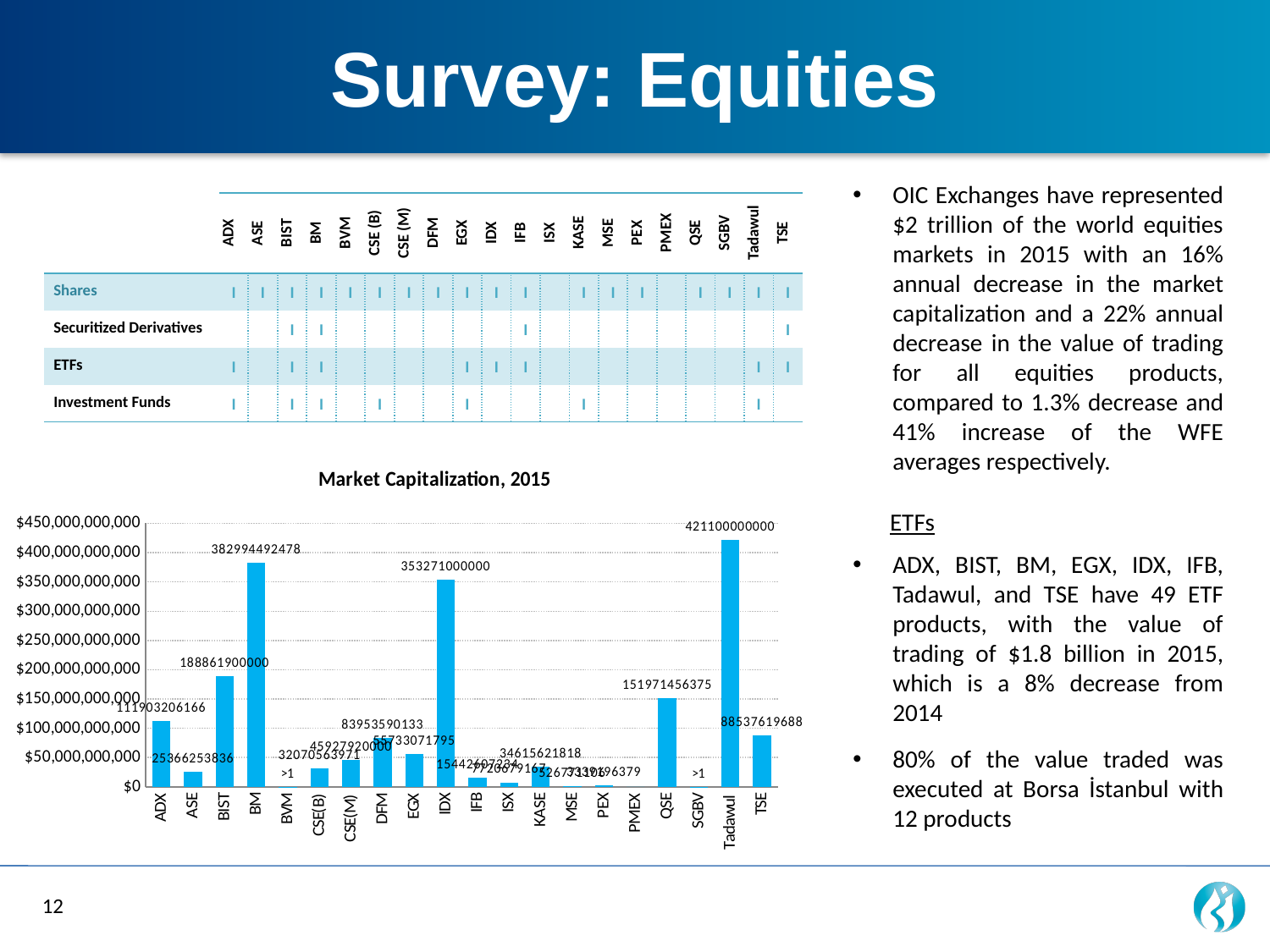
In the Market Capitalization, 2015 chart, what is the value for QSE? 151971456375 In the Market Capitalization, 2015 chart, is the value for EGX greater or less than $100,000,000,000? less In the Market Capitalization, 2015 chart, which exchange has the highest market capitalization? Tadawul In the Market Capitalization, 2015 chart, what is the difference between the values for Tadawul and BM? 38105507522 What kind of chart is the Market Capitalization, 2015 chart? bar chart How many exchanges are shown on the x axis of the Market Capitalization, 2015 chart? 20 In the Market Capitalization, 2015 chart, what is the value for Tadawul? 421100000000 What is the title of the chart at the bottom left of the slide? Market Capitalization, 2015 In the Market Capitalization, 2015 chart, what is the value for BM? 382994492478 In the Market Capitalization, 2015 chart, which is larger, the value for BIST or the value for QSE? BIST In the Market Capitalization, 2015 chart, what is the value for ADX? 111903206166 In the Market Capitalization, 2015 chart, what is the value for IDX? 353271000000